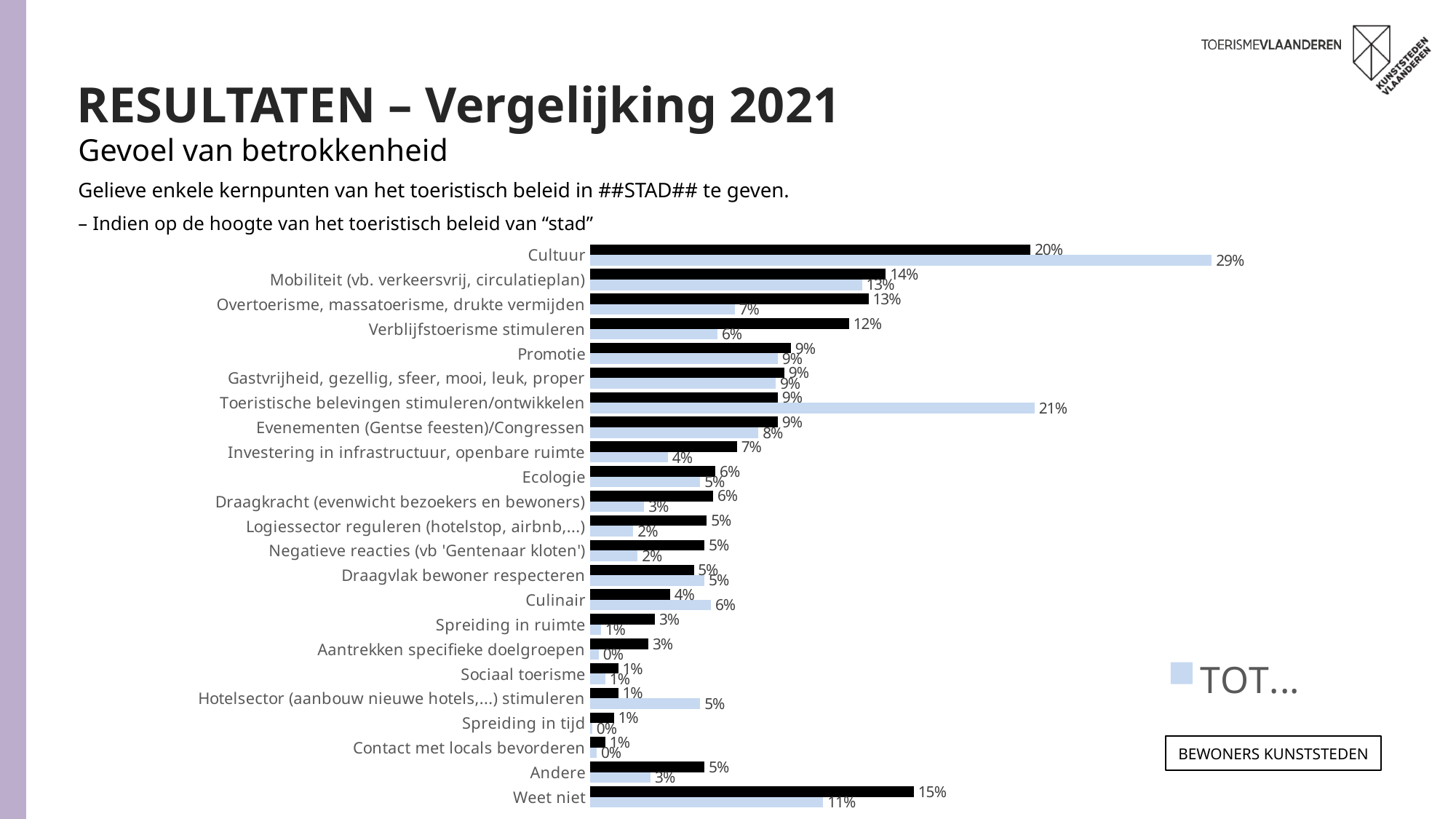
What is the value of the light blue bar for Hotelsector (aanbouw nieuwe hotels,...) stimuleren? 5% What is the value of the light blue bar for Toeristische belevingen stimuleren/ontwikkelen? 21% Which category has the highest black bar value? Cultuur Which category has the highest light blue bar value? Cultuur What is the value of the light blue bar for Cultuur? 29% What kind of chart is shown on the slide? bar chart For Weet niet, which bar is larger, the black bar or the light blue bar? the black bar What is the value of the black bar for Cultuur? 20% What is the value of the black bar for Weet niet? 15% What is the difference between the light blue bar and the black bar for Toeristische belevingen stimuleren/ontwikkelen? 12% What is the difference between the light blue bar and the black bar for Cultuur? 9% How many categories are shown on the chart? 23